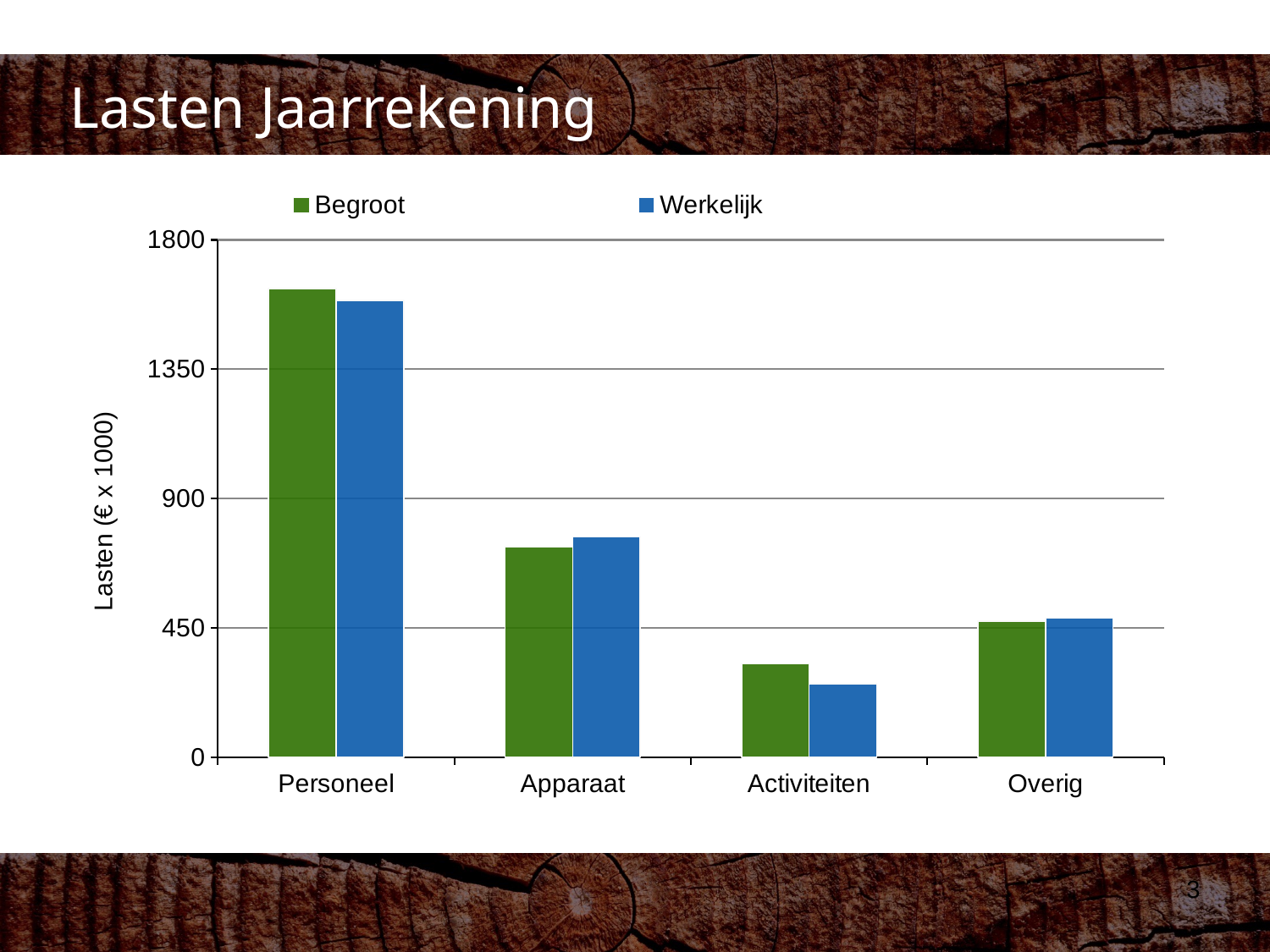
What is the title of the y axis? Lasten (€ x 1000) What kind of chart is shown on the slide? bar chart Is the Begroot value for Personeel greater or less than 1350? greater Which colour represents the Werkelijk series? blue Which category has the lowest Werkelijk value? Activiteiten For Activiteiten, which is larger: Begroot or Werkelijk? Begroot Which category has the highest Begroot value? Personeel How many categories are shown on the x axis? 4 For Personeel, which is larger: Begroot or Werkelijk? Begroot Is the Werkelijk value for Activiteiten greater or less than 450? less How many series does the legend list? 2 Is the Werkelijk value for Apparaat greater or less than 900? less